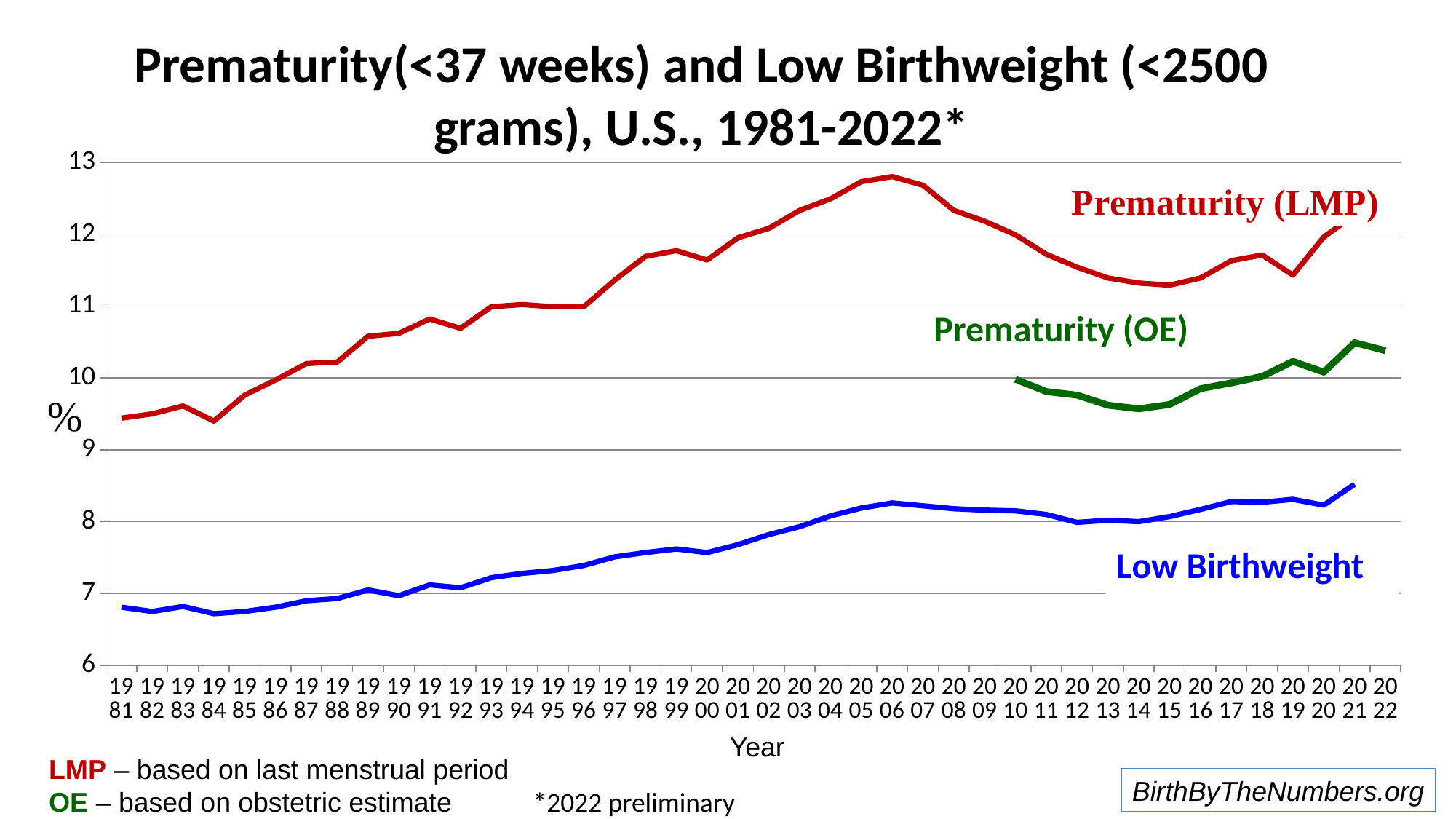
Is the Low Birthweight value for 1981 greater or less than 7? less What kind of chart is shown on the slide? Line chart Is the Prematurity (OE) value for 2014 greater or less than 10? less In which year does the Low Birthweight line reach its highest value? 2021 According to the slide, what does LMP stand for? Based on last menstrual period Is the Prematurity (LMP) value for 1981 greater or less than 10? less In which year does the Prematurity (LMP) line reach its highest value? 2006 How many data series are plotted on the chart? 3 Does the Low Birthweight line generally rise or fall from 1981 to 2006? rise How many years are shown along the x axis of the chart? 42